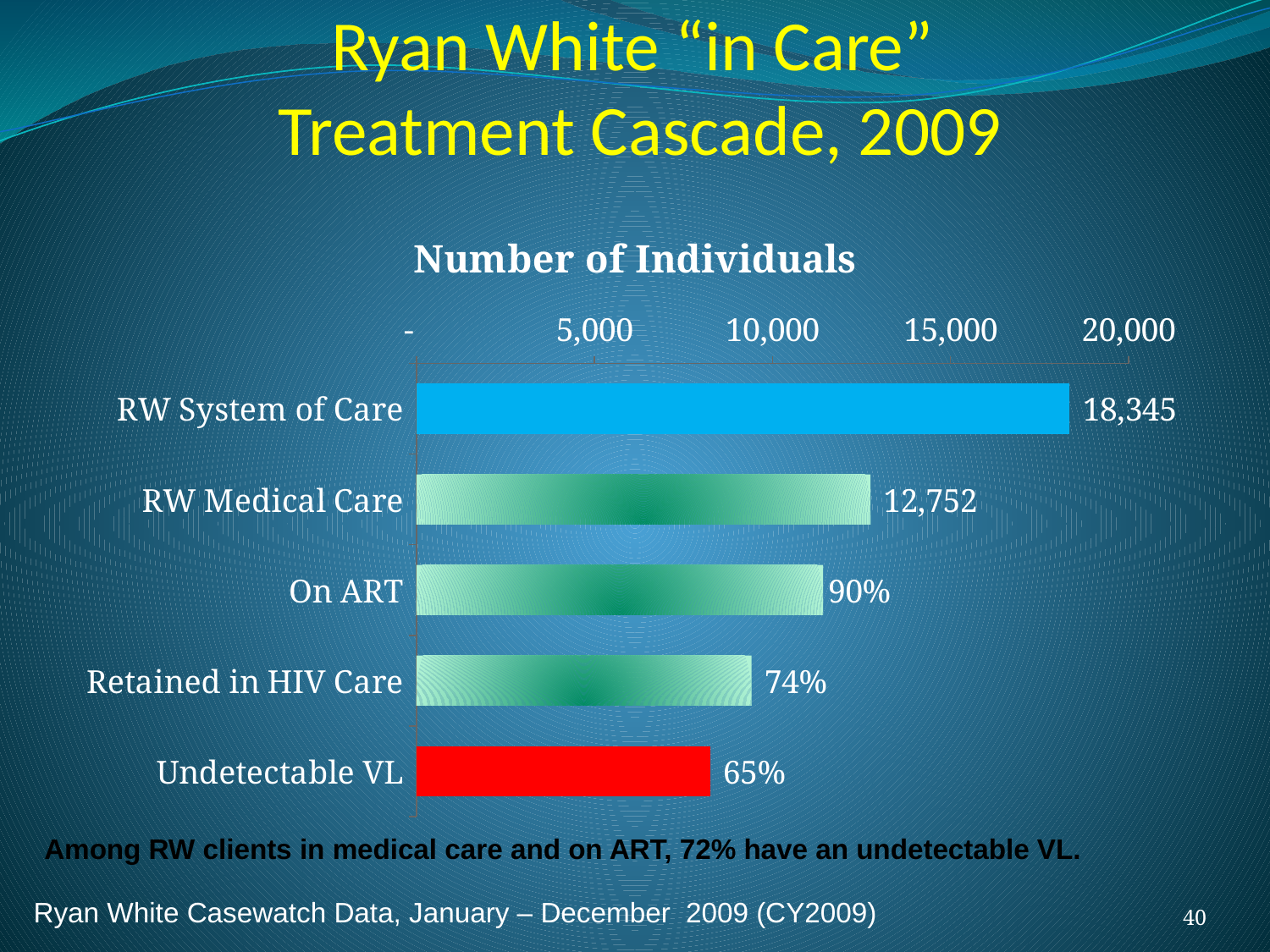
What label is shown on the On ART bar? 90% What is the title of the chart? Number of Individuals What label is shown on the Retained in HIV Care bar? 74% What value is shown for RW System of Care? 18,345 Is the bar for On ART greater or less than 10,000 on the axis? greater What kind of chart is shown on the slide? bar chart Which category has the shortest bar? Undetectable VL What label is shown on the Undetectable VL bar? 65% What is the difference between the values for RW System of Care and RW Medical Care? 5,593 Which category has the longest bar? RW System of Care What value is shown for RW Medical Care? 12,752 How many categories are shown in the chart? 5